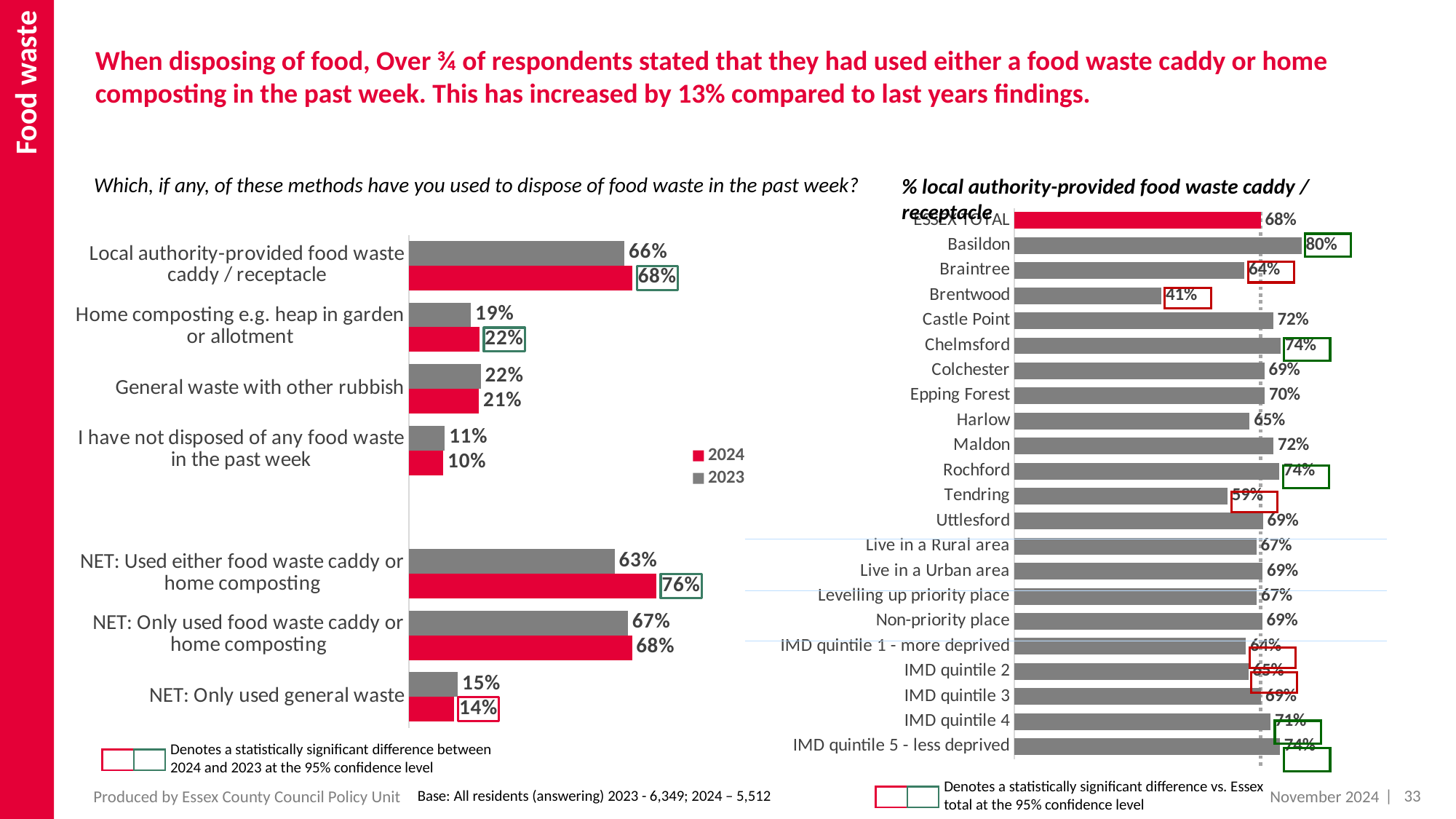
In the right chart '% local authority-provided food waste caddy / receptacle', what is the value for Tendring? 59% In the right chart '% local authority-provided food waste caddy / receptacle', which area has the lowest value? Brentwood In the left chart on methods used to dispose of food waste, what is the difference between the 2024 and 2023 values for 'NET: Used either food waste caddy or home composting'? 13% In the left chart on methods used to dispose of food waste, how many series does the legend list? 2 In the right chart '% local authority-provided food waste caddy / receptacle', what is the difference between Basildon and Brentwood? 39% In the left chart on methods used to dispose of food waste, which series has the larger value for 'General waste with other rubbish', 2024 or 2023? 2023 In the right chart '% local authority-provided food waste caddy / receptacle', what is the value for ESSEX TOTAL? 68% In the left chart on methods used to dispose of food waste, what is the 2024 value for 'NET: Used either food waste caddy or home composting'? 76% In the left chart on methods used to dispose of food waste, what type of chart is used? Bar chart In the left chart on methods used to dispose of food waste, what is the 2023 value for 'Home composting e.g. heap in garden or allotment'? 19% In the right chart '% local authority-provided food waste caddy / receptacle', which is larger, the value for 'Live in a Rural area' or 'Live in a Urban area'? Live in a Urban area In the right chart '% local authority-provided food waste caddy / receptacle', which district has the highest value? Basildon